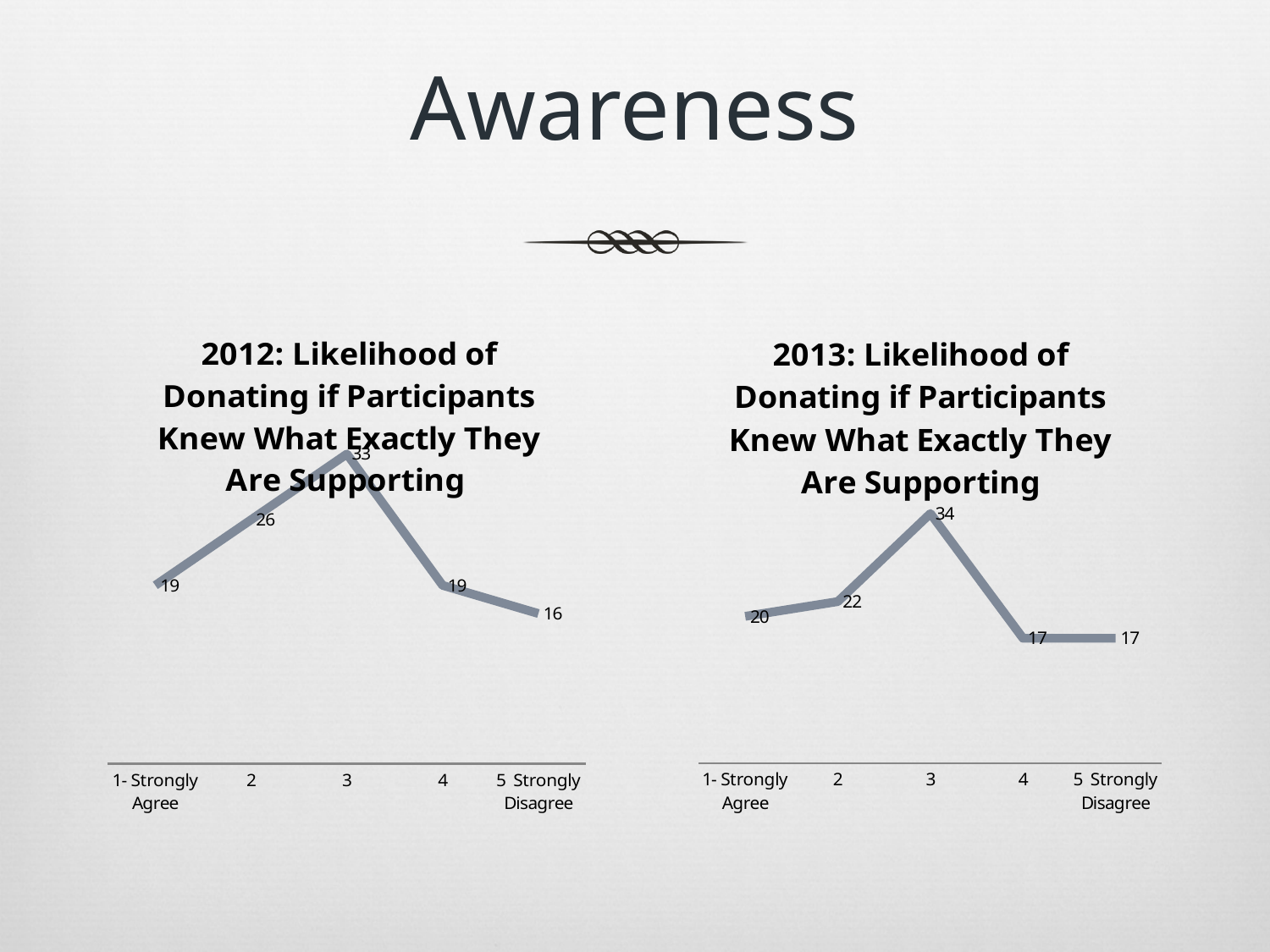
In the 2013 chart, which category has the highest value? 3 How many categories are shown on the x axis of the 2012 chart? 5 In the 2012 chart, what is the difference between the values for category 2 and '1- Strongly Agree'? 7 In the 2012 chart, what is the value for category 3? 33 In the 2013 chart, what is the difference between the values for category 3 and category 4? 17 What kind of chart is the 2013 chart? line chart In the 2012 chart, what is the value for '5 Strongly Disagree'? 16 In the 2012 chart, do the values rise or fall from category 3 to '5 Strongly Disagree'? fall In the 2012 chart, which category has the lowest value? 5 Strongly Disagree Which is larger: the value for category 3 in the 2012 chart or the value for category 3 in the 2013 chart? 2013 chart In the 2013 chart, what is the value for category 2? 22 In the 2013 chart, is the value for '1- Strongly Agree' larger or smaller than the value for category 2? smaller